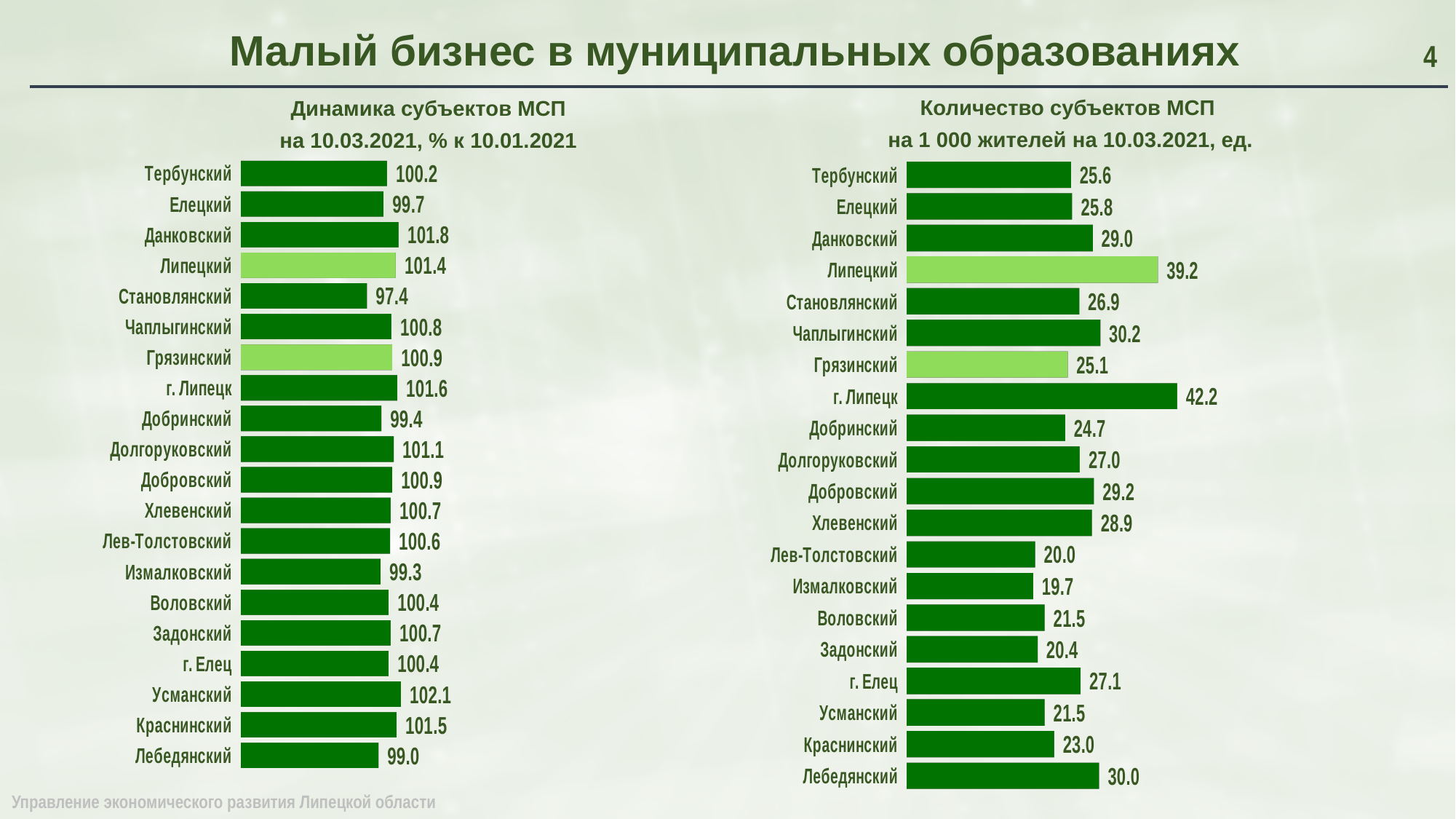
In the right chart (Количество субъектов МСП на 1 000 жителей), which municipality has the lowest value? Измалковский In the right chart (Количество субъектов МСП на 1 000 жителей), what is the difference between г. Липецк and Липецкий? 3.0 How many municipalities are shown in the left chart (Динамика субъектов МСП)? 20 In the left chart (Динамика субъектов МСП), what is the difference between the highest value (Усманский) and the lowest value (Становлянский)? 4.7 In the right chart (Количество субъектов МСП на 1 000 жителей), what is the value for Лев-Толстовский? 20.0 In the left chart (Динамика субъектов МСП), what is the value for Усманский? 102.1 In the left chart (Динамика субъектов МСП), which municipality has the highest value? Усманский In the right chart (Количество субъектов МСП на 1 000 жителей), which municipality has the highest value? г. Липецк What type of chart is used on the right side of the slide (Количество субъектов МСП на 1 000 жителей)? Bar chart In the right chart (Количество субъектов МСП на 1 000 жителей), what is the value for Липецкий? 39.2 In the left chart (Динамика субъектов МСП), which municipality has the lowest value? Становлянский In the right chart (Количество субъектов МСП на 1 000 жителей), which is larger: Чаплыгинский or Лебедянский? Чаплыгинский